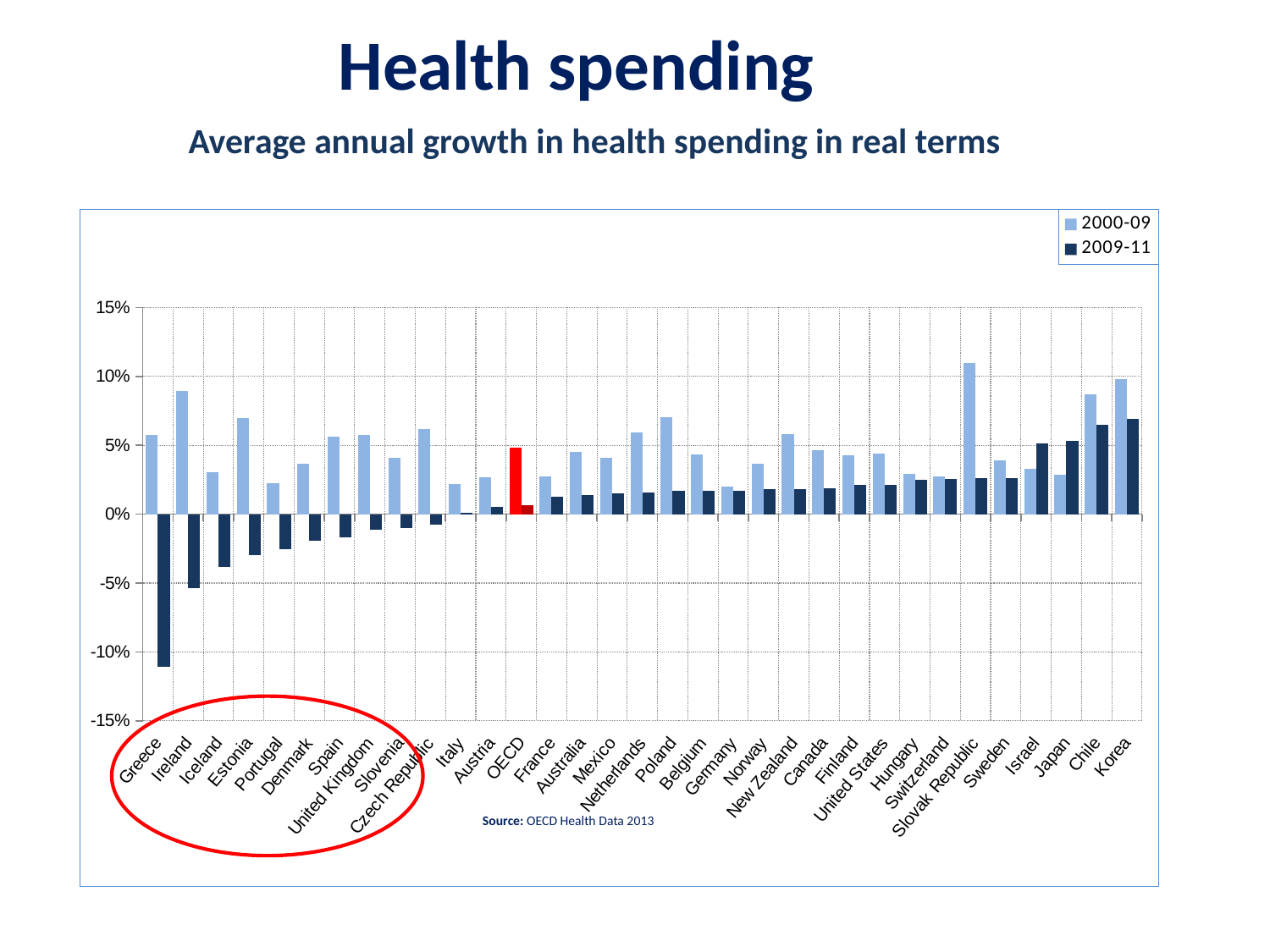
Which category has the highest value for the 2000-09 series? Slovak Republic Is the 2000-09 value for Korea greater or less than 5%? greater Is the 2000-09 value for Slovak Republic greater or less than 10%? greater For the 2000-09 series, which is larger: Greece or Ireland? Ireland How many series does the legend list? 2 Is the 2009-11 value for Greece greater or less than -10%? less Which category has the highest value for the 2009-11 series? Korea How many countries/categories are shown on the x axis? 33 Which category has the lowest value for the 2009-11 series? Greece What kind of chart is shown on the slide? bar chart Do the 2009-11 values generally rise or fall moving from left to right along the x axis? rise Which category's bar is highlighted in red? OECD